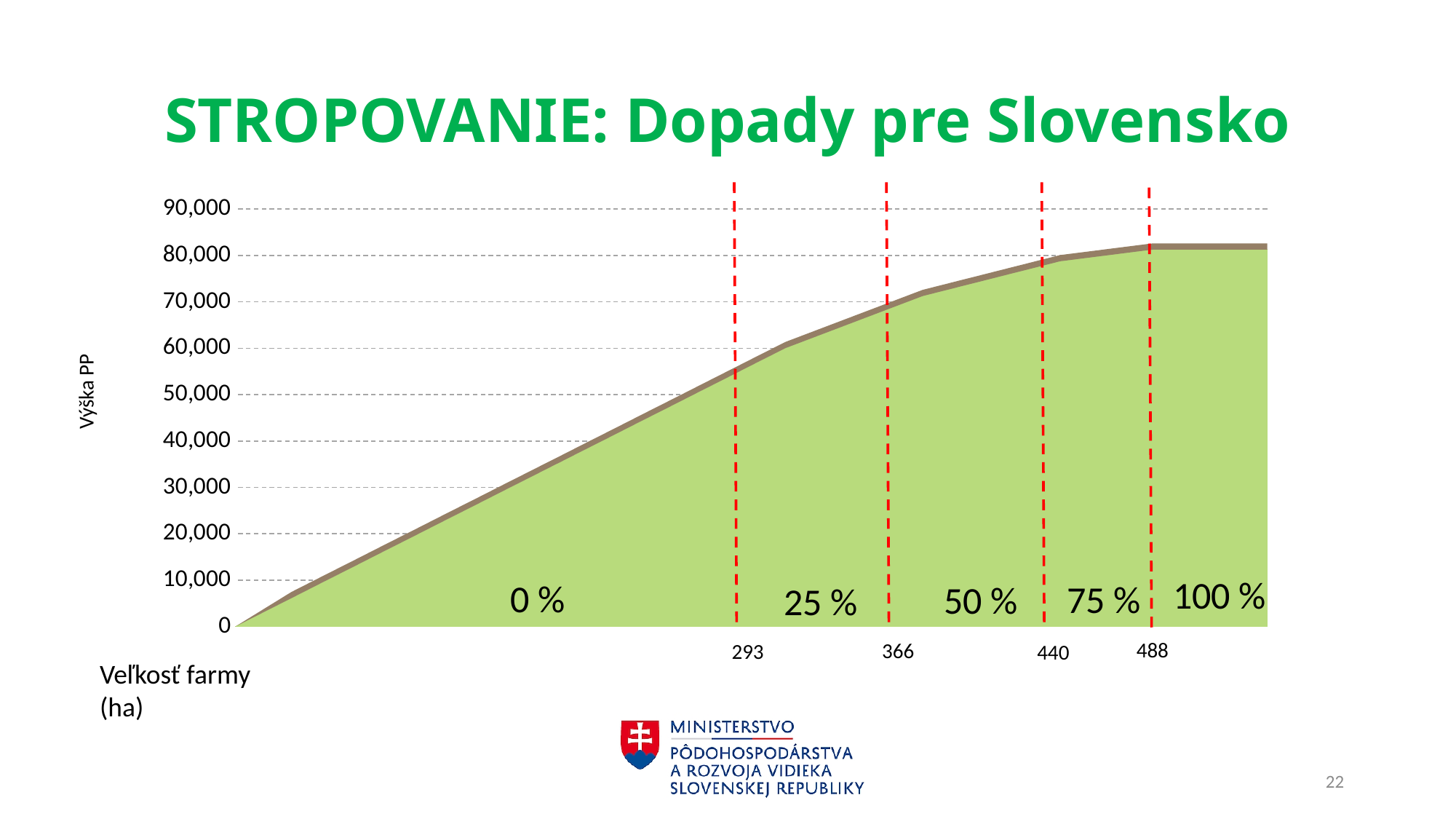
How many red dashed vertical lines are drawn on the chart? 4 What is the label of the horizontal axis? Veľkosť farmy (ha) Is the value at the farm size of 440 ha greater or less than 70,000? greater Is the value at the farm size of 366 ha greater or less than 60,000? greater Which farm size (in ha) marks the boundary between the 75 % and 100 % zones? 488 Is the value at the farm size of 293 ha greater or less than 50,000? greater Does the plotted value rise or fall as farm size increases along the x axis? rise Which farm size (in ha) marks the boundary between the 0 % and 25 % zones? 293 What kind of chart is shown on the slide? area chart What is the label of the vertical axis? Výška PP